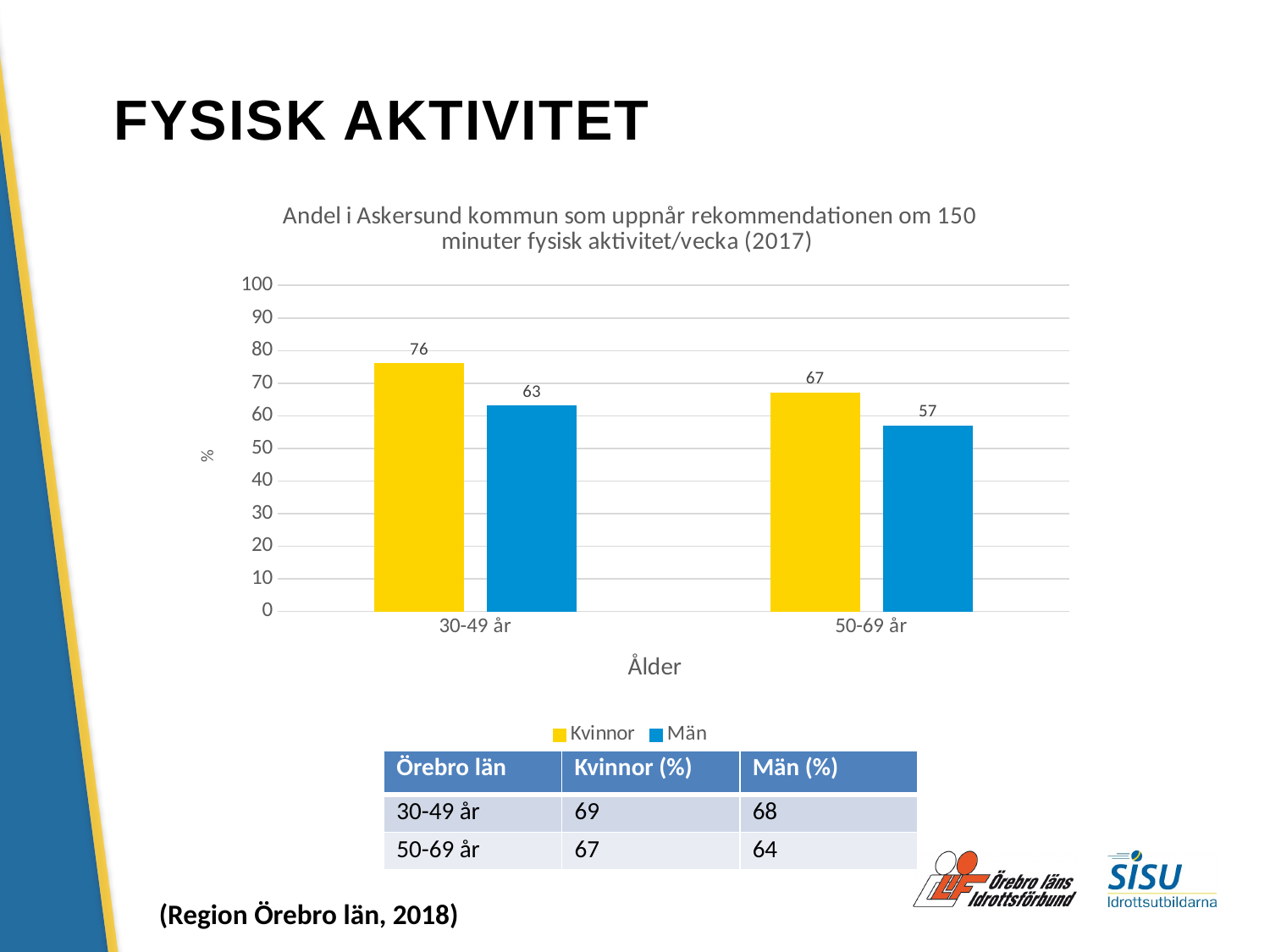
What is the value for Kvinnor in the 30-49 år category? 76 What is the difference between Kvinnor and Män in the 30-49 år category? 13 How many series does the legend list? 2 What kind of chart is shown on the slide? Bar chart How many age categories are shown on the x axis? 2 What is the value for Män in the 30-49 år category? 63 What is the difference between the Kvinnor values for 30-49 år and 50-69 år? 9 What is the value for Män in the 50-69 år category? 57 Which age group has the highest value for Kvinnor? 30-49 år Which is larger, the Kvinnor value for 50-69 år or the Män value for 30-49 år? Kvinnor value for 50-69 år Which bar in the chart has the lowest value? Män, 50-69 år Which colour represents Män in the chart? Blue